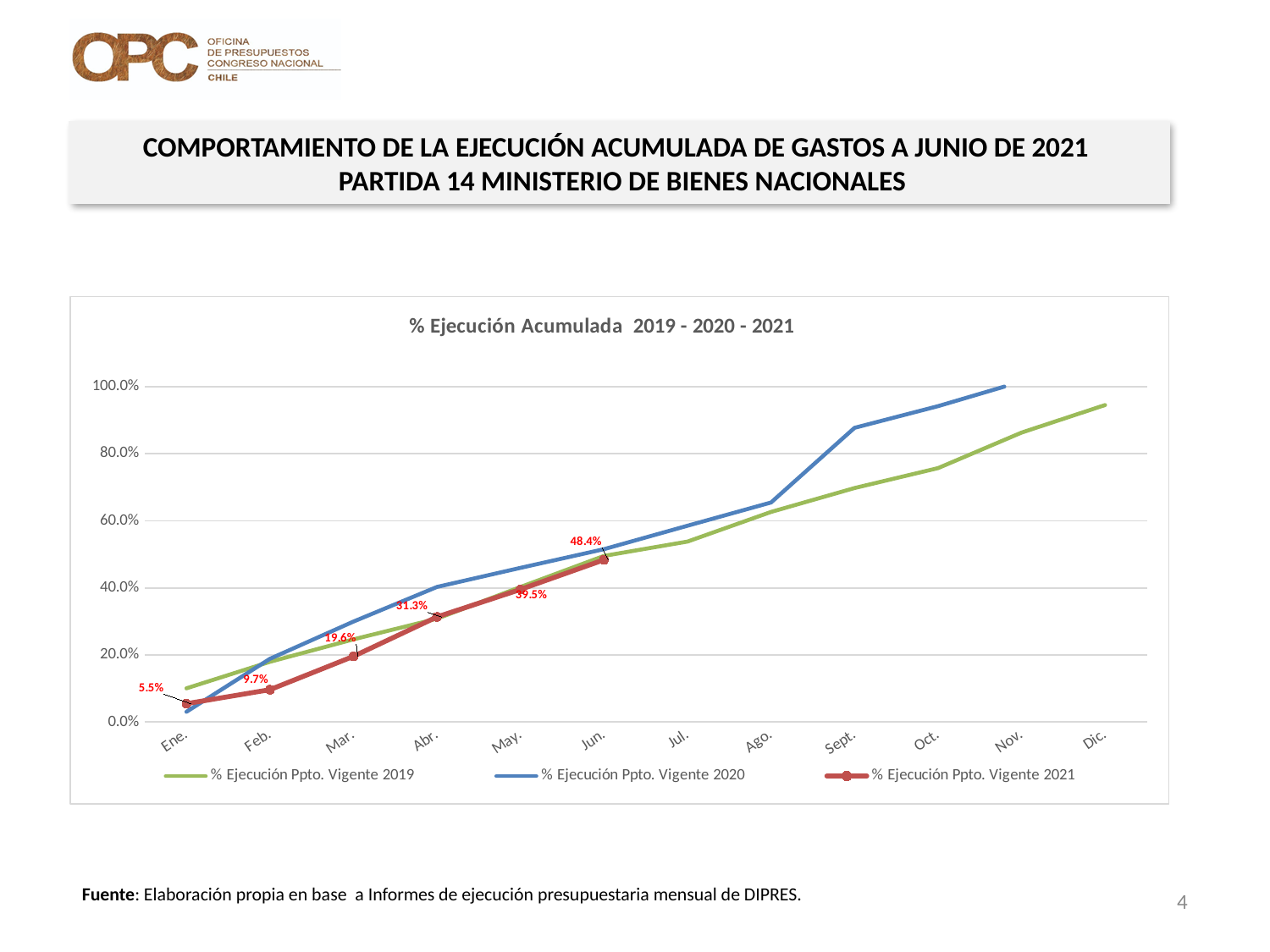
How many months are shown on the x axis? 12 What is the value of % Ejecución Ppto. Vigente 2021 in Mar.? 19.6% What type of chart is shown on the slide? line chart What is the value of % Ejecución Ppto. Vigente 2021 in Ene.? 5.5% Which of the two is larger for % Ejecución Ppto. Vigente 2021: Feb. or Mar.? Mar. Is the value for % Ejecución Ppto. Vigente 2020 in Sept. greater or less than 80.0%? greater What is the title of the chart? % Ejecución Acumulada 2019 - 2020 - 2021 What is the value of % Ejecución Ppto. Vigente 2021 in Abr.? 31.3% How many series does the legend list? 3 What is the value of % Ejecución Ppto. Vigente 2021 in Jun.? 48.4% Does the % Ejecución Ppto. Vigente 2021 line rise or fall from Ene. to Jun.? rise What is the difference between the % Ejecución Ppto. Vigente 2021 values for Jun. and May.? 8.9%